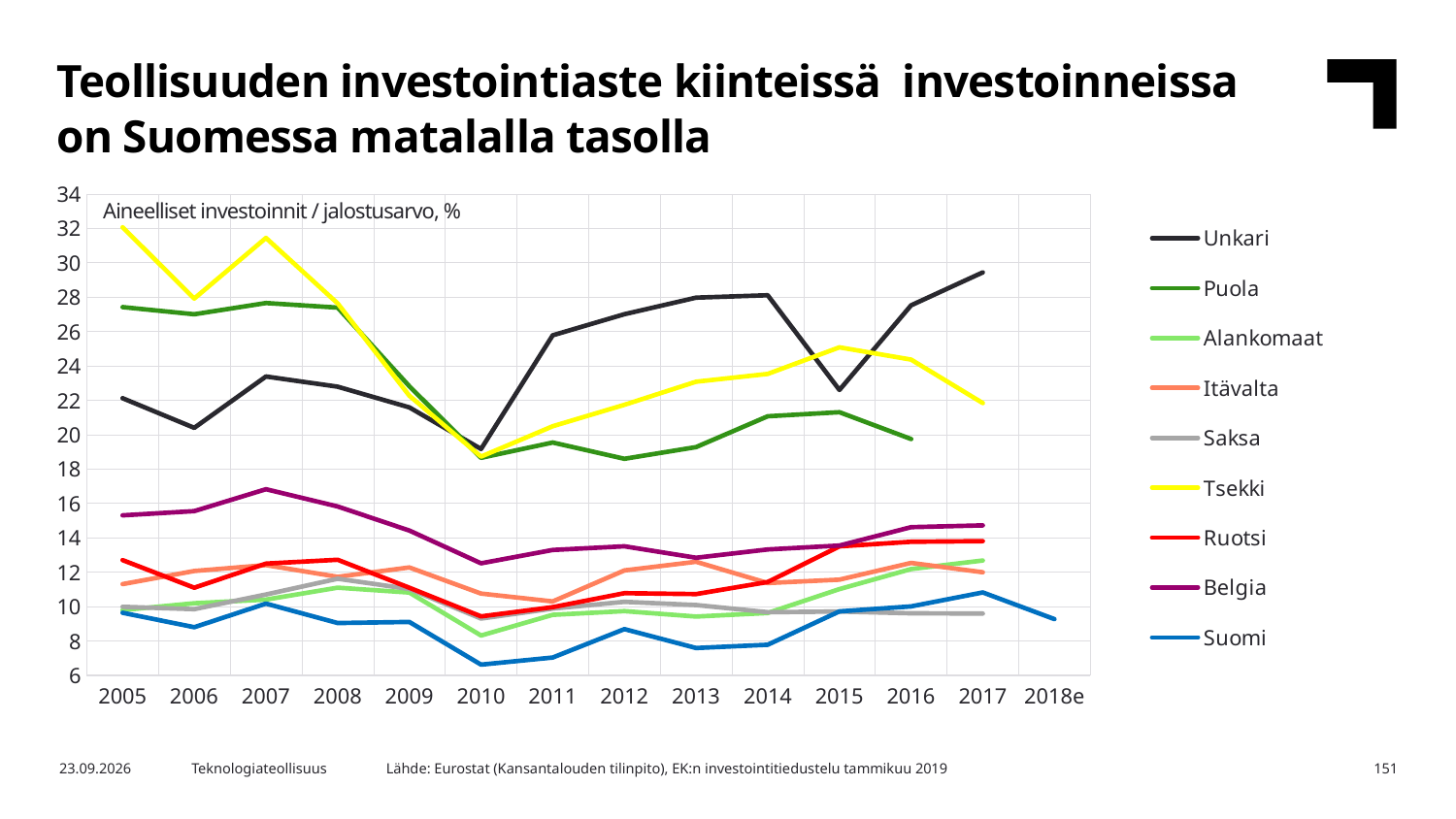
How many years are shown on the x axis? 14 What label is printed inside the plot area at the top left of the chart? Aineelliset investoinnit / jalostusarvo, % Which country has the highest value in 2005? Tsekki Does the value for Suomi rise or fall from 2017 to 2018e? fall In 2014, which is larger: the value for Unkari or the value for Tsekki? Unkari What kind of chart is shown on the slide? line chart Which country has the lowest value in 2010? Suomi Is the value for Puola in 2012 greater or less than 20? less Is the value for Suomi in 2010 greater or less than 8? less How many series does the legend list? 9 Which country has the highest value in 2017? Unkari Is the value for Tsekki in 2005 greater or less than 30? greater